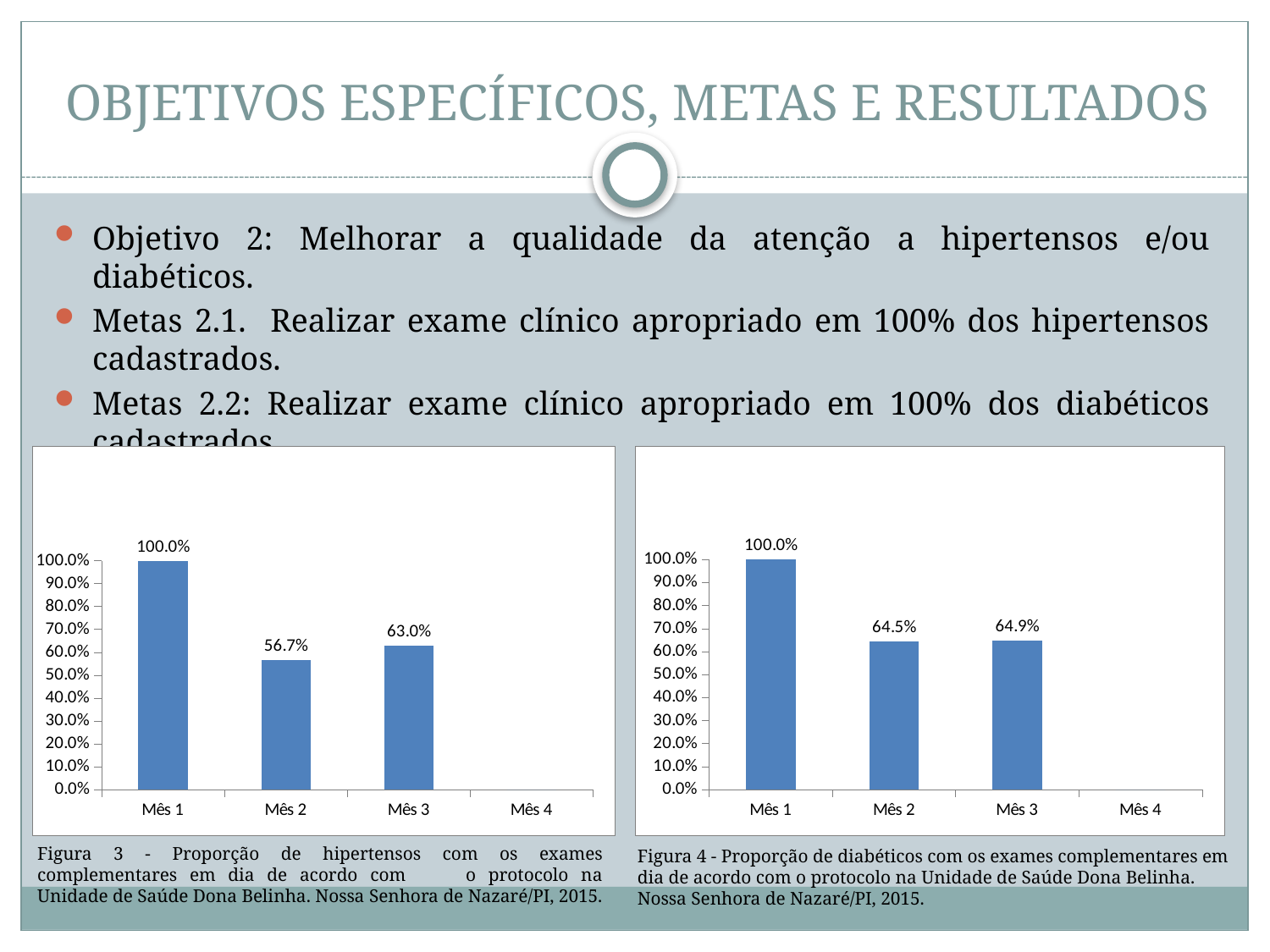
In the left chart (Figura 3, hipertensos), is the value for Mês 3 larger or smaller than the value for Mês 2? larger In the left chart (Figura 3, hipertensos), what is the value for Mês 3? 63.0% In the left chart (Figura 3, hipertensos), what is the difference between the values for Mês 1 and Mês 2? 43.3% In the right chart (Figura 4, diabéticos), which month has the highest value? Mês 1 In the left chart (Figura 3, hipertensos), which month has the highest value? Mês 1 In the right chart (Figura 4, diabéticos), what is the value for Mês 3? 64.9% How many month categories are shown on the x axis of the right chart (Figura 4, diabéticos)? 4 In the left chart (Figura 3, hipertensos), what is the value for Mês 2? 56.7% In the right chart (Figura 4, diabéticos), what is the value for Mês 2? 64.5% In the right chart (Figura 4, diabéticos), what is the difference between the values for Mês 3 and Mês 2? 0.4% What kind of chart is the left chart (Figura 3, hipertensos)? bar chart In the left chart (Figura 3, hipertensos), which of the plotted months has the lowest value? Mês 2